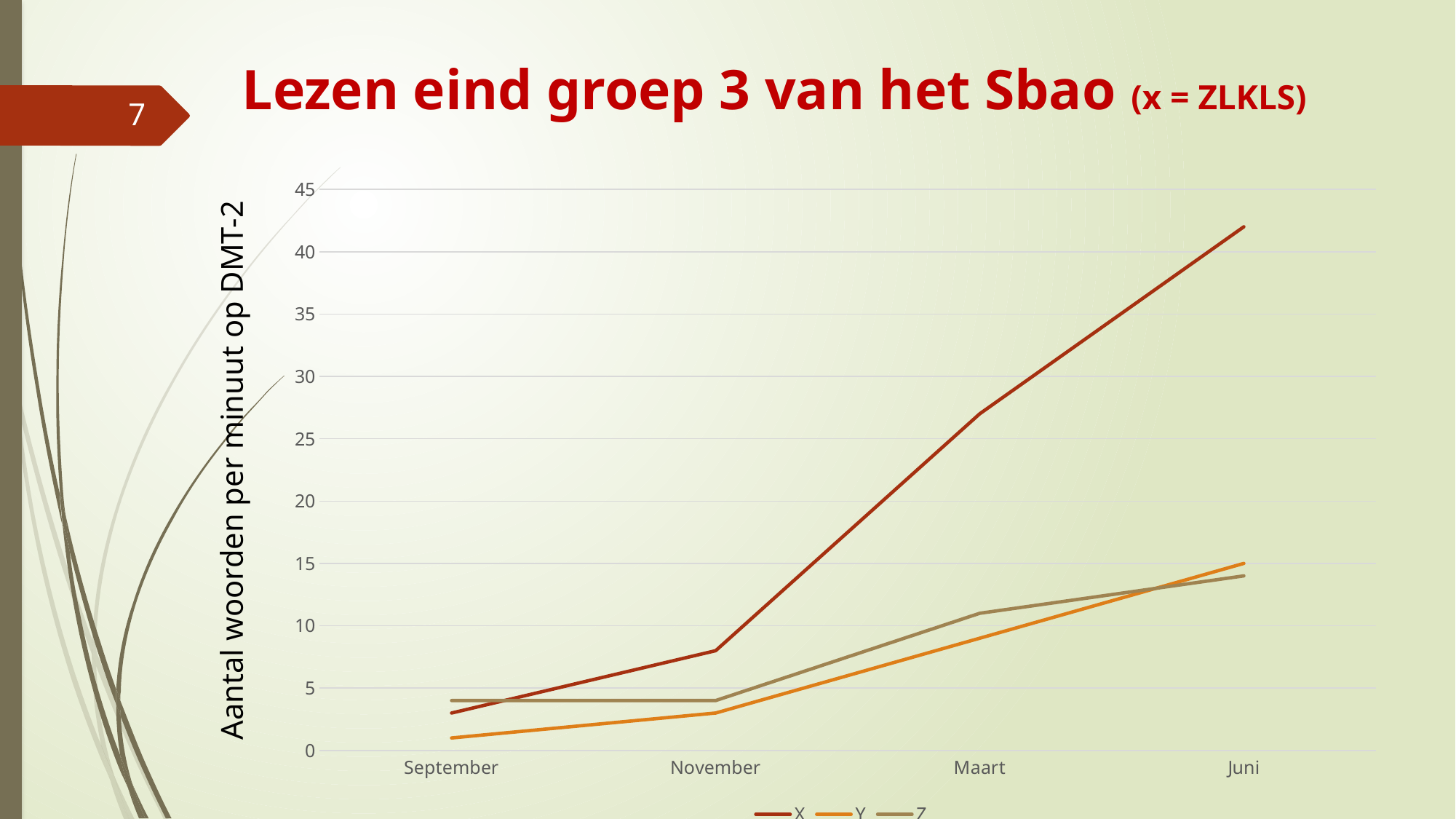
Which series has the lowest value in September? Y What is the label on the vertical axis? Aantal woorden per minuut op DMT-2 How many months are shown on the x axis? 4 Which series has the highest value in Juni? X In Juni, which series has the larger value, X or Y? X Is the value for series Y in September greater or less than 5? less What kind of chart is shown on the slide? line chart Is the value for series X in Juni greater or less than 35? greater Does the value for series X rise or fall from September to Juni? rise Is the value for series X in Maart greater or less than 20? greater How many series does the legend list? 3